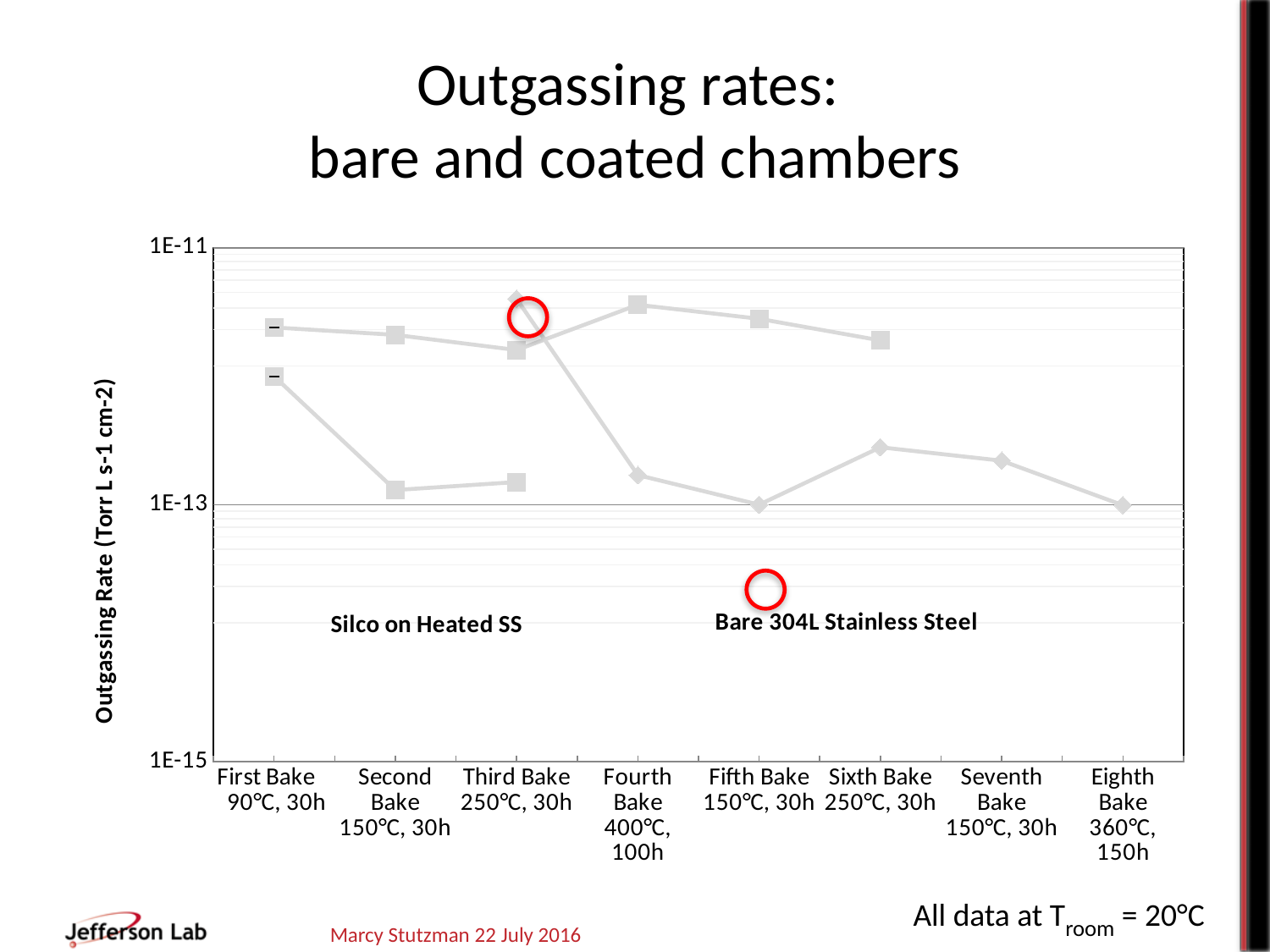
What temperature and duration are listed for the Fourth Bake on the x axis? 400°C, 100h Is the Bare 304L Stainless Steel value at the Sixth Bake greater or less than 1E-11? less What kind of chart is shown on the slide? line chart At the Fourth Bake, which series has the higher outgassing rate, Silco on Heated SS or Bare 304L Stainless Steel? Silco on Heated SS Does the Bare 304L Stainless Steel outgassing rate rise or fall from the Third Bake to the Fourth Bake? fall Is the Bare 304L Stainless Steel value at the Third Bake greater or less than 1E-13? greater Which bake has the highest outgassing rate for Bare 304L Stainless Steel? Third Bake 250°C, 30h What is the y-axis title of the chart? Outgassing Rate (Torr L s-1 cm-2) How many bake steps are shown along the x axis? 8 For Bare 304L Stainless Steel, is the outgassing rate at the Third Bake higher or lower than at the Eighth Bake? higher Is the Silco on Heated SS value at the Fourth Bake greater or less than 1E-13? greater How many data series are labelled on the chart? 2